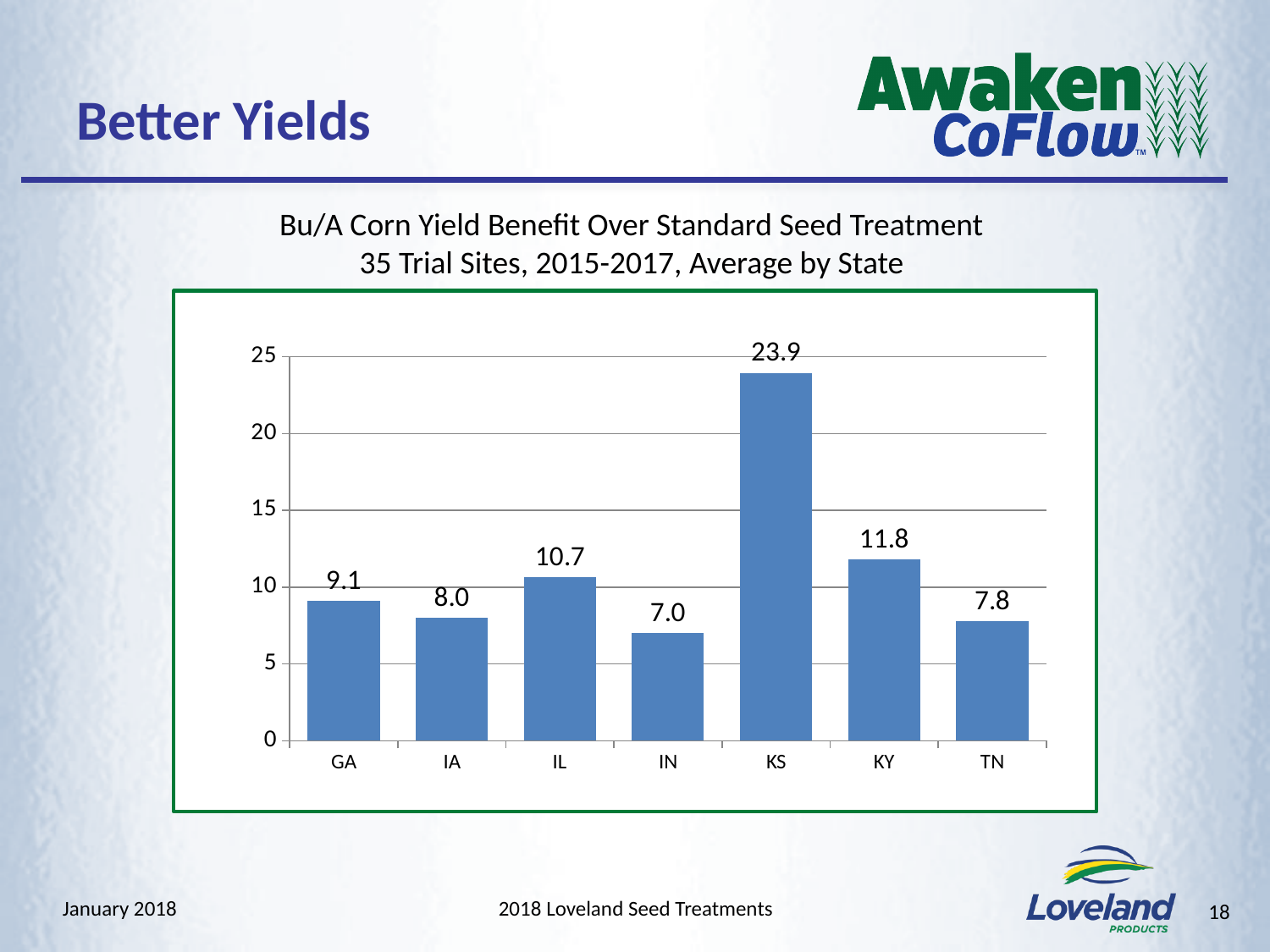
What is the difference between the values for KS and KY? 12.1 Which state has the lowest corn yield benefit? IN What is the title of the chart? Bu/A Corn Yield Benefit Over Standard Seed Treatment 35 Trial Sites, 2015-2017, Average by State Which state has the highest corn yield benefit? KS What is the corn yield benefit value for TN? 7.8 What kind of chart is shown on the slide? bar chart Which is larger, the value for IL or the value for KY? KY What is the corn yield benefit value for KS? 23.9 What is the difference between the values for GA and IA? 1.1 What is the corn yield benefit value for IL? 10.7 How many states are shown on the chart? 7 Is the value for KS greater or less than 20? greater